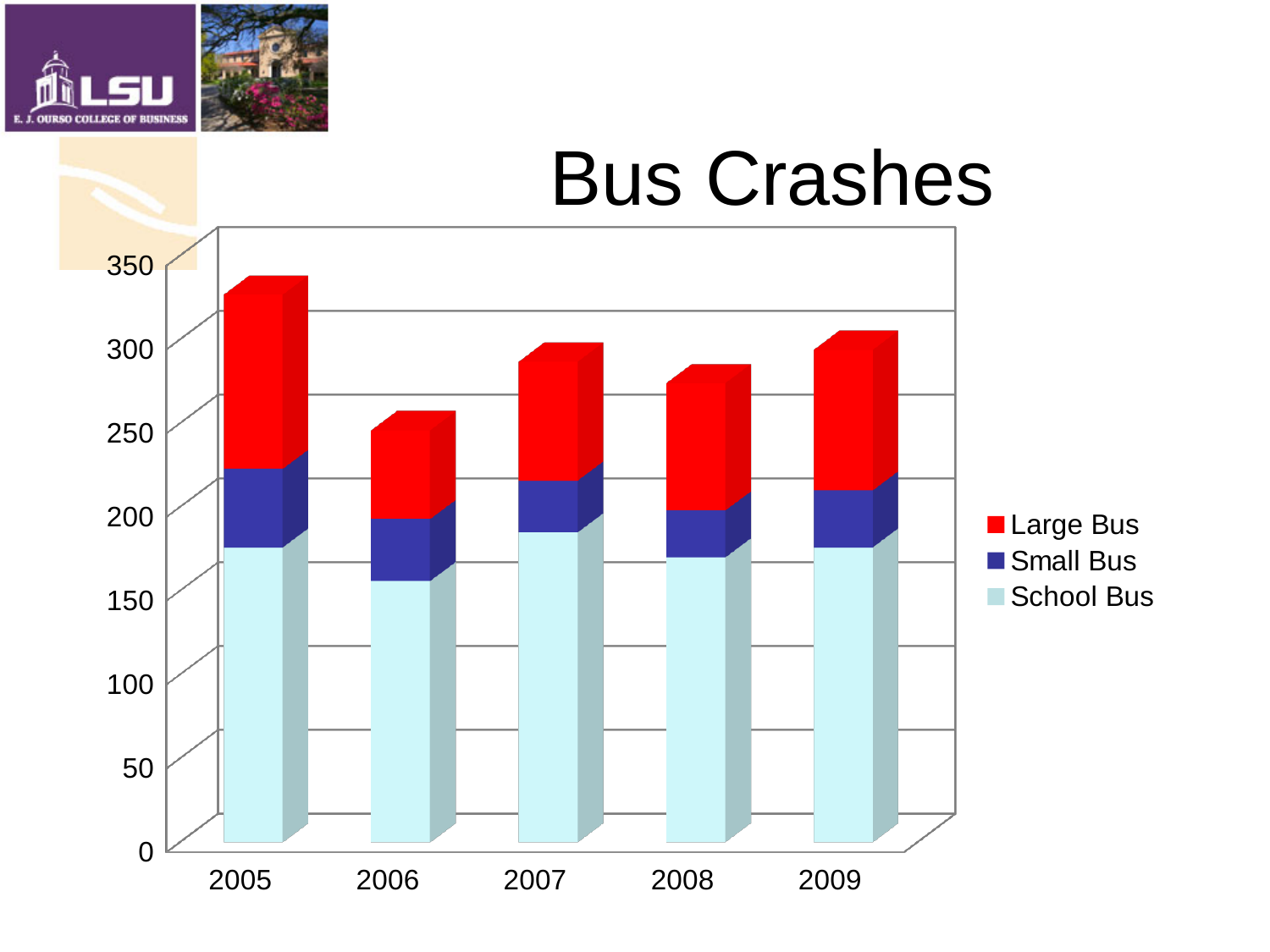
Do total bus crashes rise or fall from 2005 to 2006? fall Is the total for 2006 greater or less than 300? less Is the School Bus value for 2006 greater or less than 200? less Which year has the highest total bus crashes? 2005 Which series is shown in red in the legend? Large Bus How many series does the legend list? 3 Which year has the lowest total bus crashes? 2006 Is the total for 2005 greater or less than 300? greater What is the title of the chart? Bus Crashes How many years are shown on the x axis of the chart? 5 Which year has the larger total bus crashes, 2006 or 2009? 2009 What kind of chart is shown on the slide? Stacked bar chart